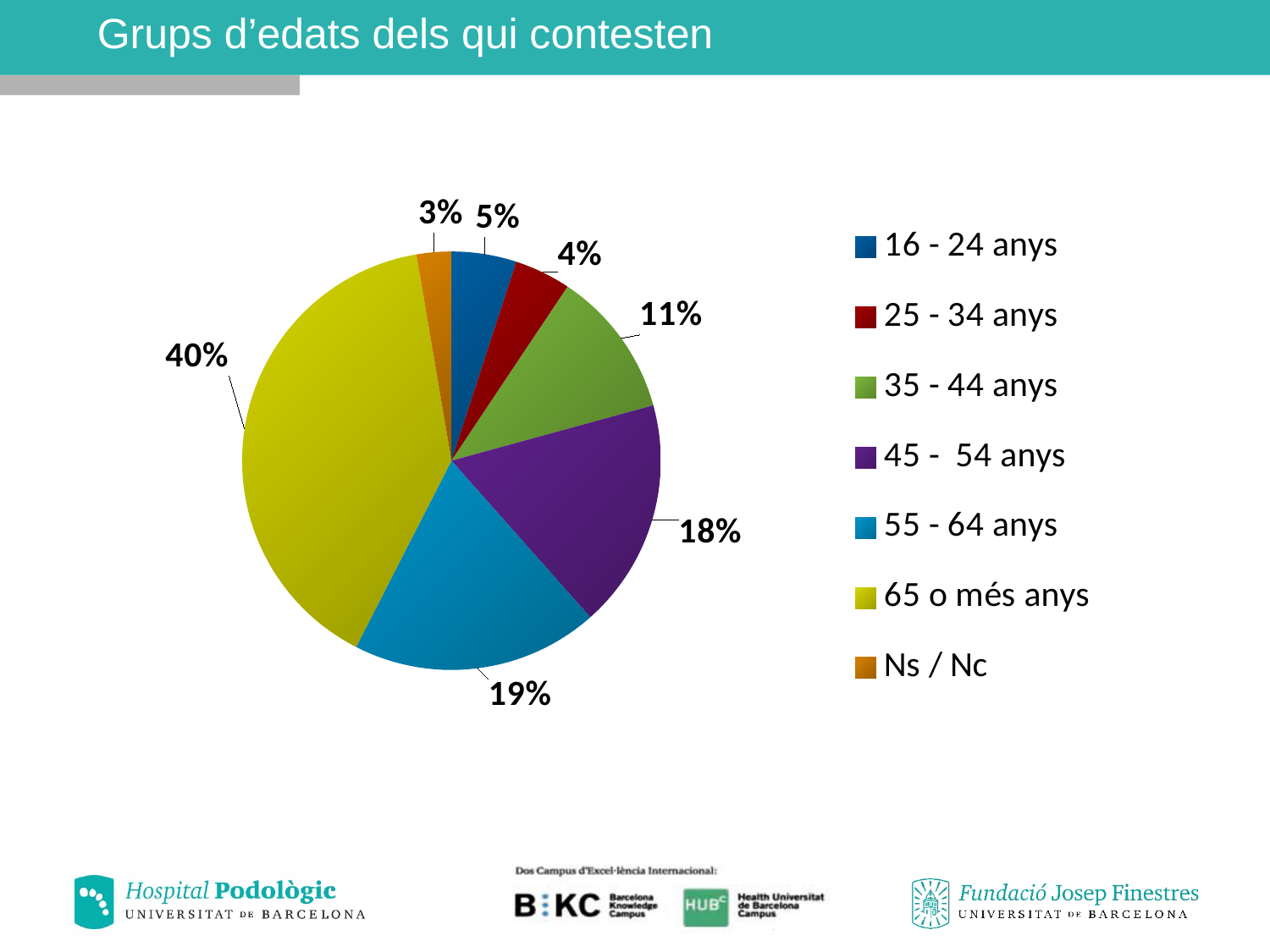
What colour is the slice for 55 - 64 anys? light blue Which age group has the largest share of the pie? 65 o més anys What share of respondents answered Ns / Nc? 3% How many categories does the legend list? 7 What is the difference between the share for 55 - 64 anys and the share for 35 - 44 anys? 8% Which is larger, the share for 25 - 34 anys or the share for 35 - 44 anys? 35 - 44 anys What kind of chart is shown on the slide? pie chart What share of respondents are in the 16 - 24 anys group? 5% Which category has the smallest share of the pie? Ns / Nc What share of respondents are in the 65 o més anys group? 40% What share of respondents are in the 45 - 54 anys group? 18% What is the title of the slide? Grups d'edats dels qui contesten